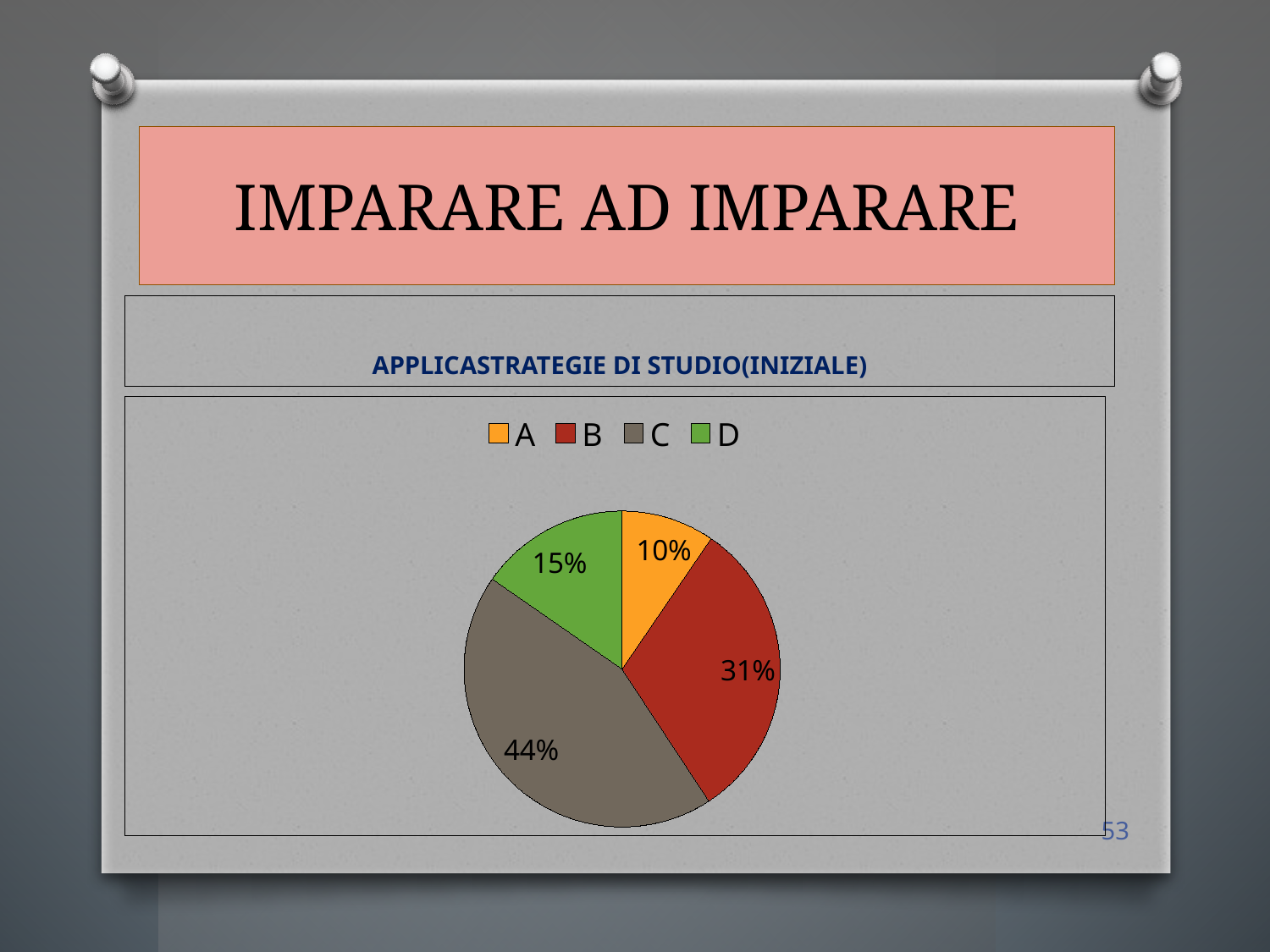
Which category has the smallest slice? A What is the value for slice B? 31% Which is larger, the value for D or the value for A? D What is the value for slice A? 10% What kind of chart is shown on the slide? pie chart Which category has the largest slice? C How many slices does the pie chart have? 4 How many entries does the legend list? 4 What is the difference between the values for C and B? 13% What is the value for slice D? 15% What is the value for slice C? 44% What is the title of the chart? APPLICASTRATEGIE DI STUDIO(INIZIALE)